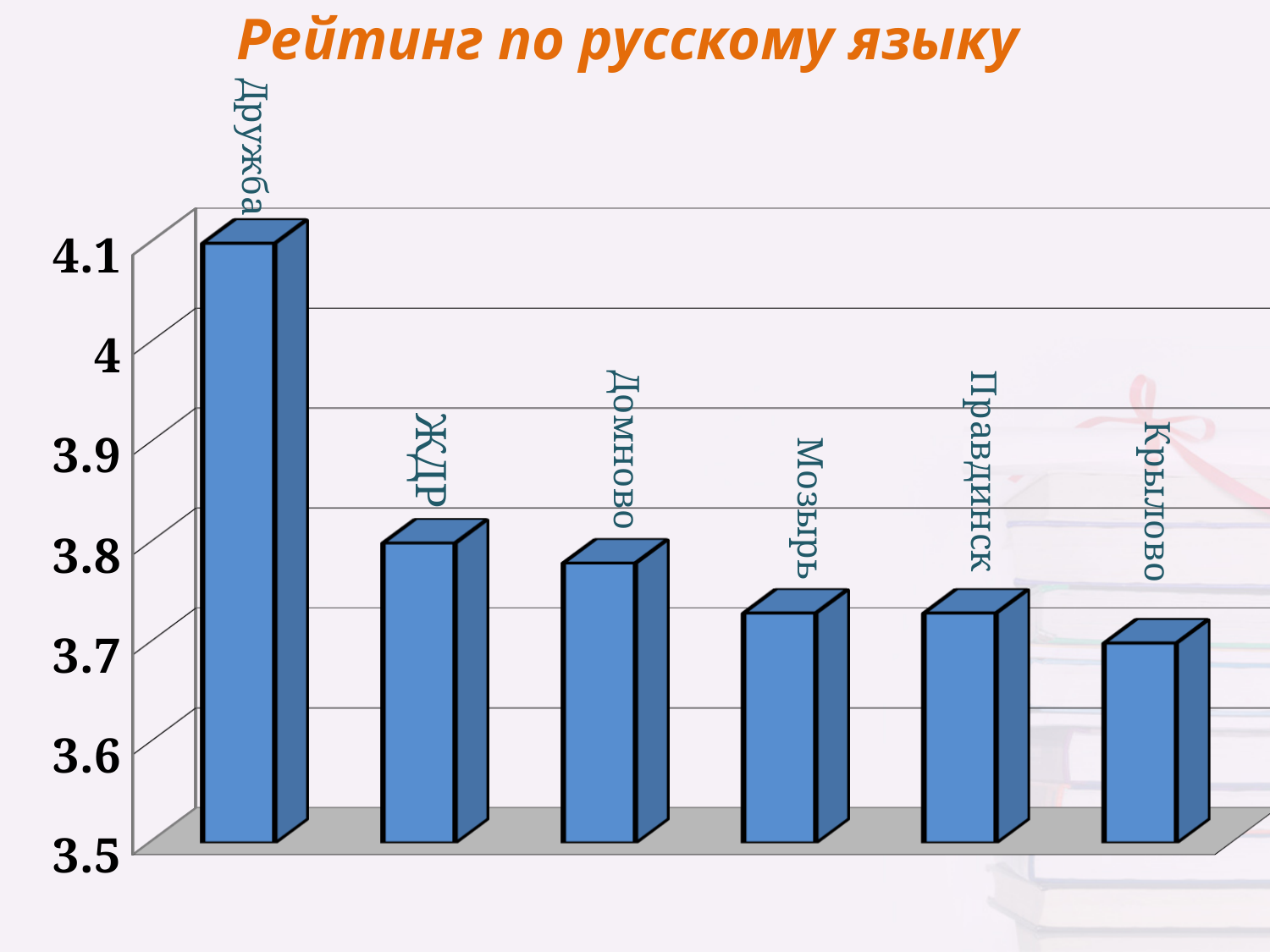
Which category has the highest value? Дружба Which category has the lowest value? Крылово Which has a larger value, Дружба or ЖДР? Дружба Is the value for ЖДР greater or less than 3.9? less What kind of chart is shown on the slide? bar chart What is the title of the chart? Рейтинг по русскому языку How many categories (bars) does the chart show? 6 Is the value for Дружба greater or less than 4? greater Which has a larger value, ЖДР or Крылово? ЖДР Do the values generally rise or fall from left to right across the categories? fall Is the value for Правдинск greater or less than 3.8? less